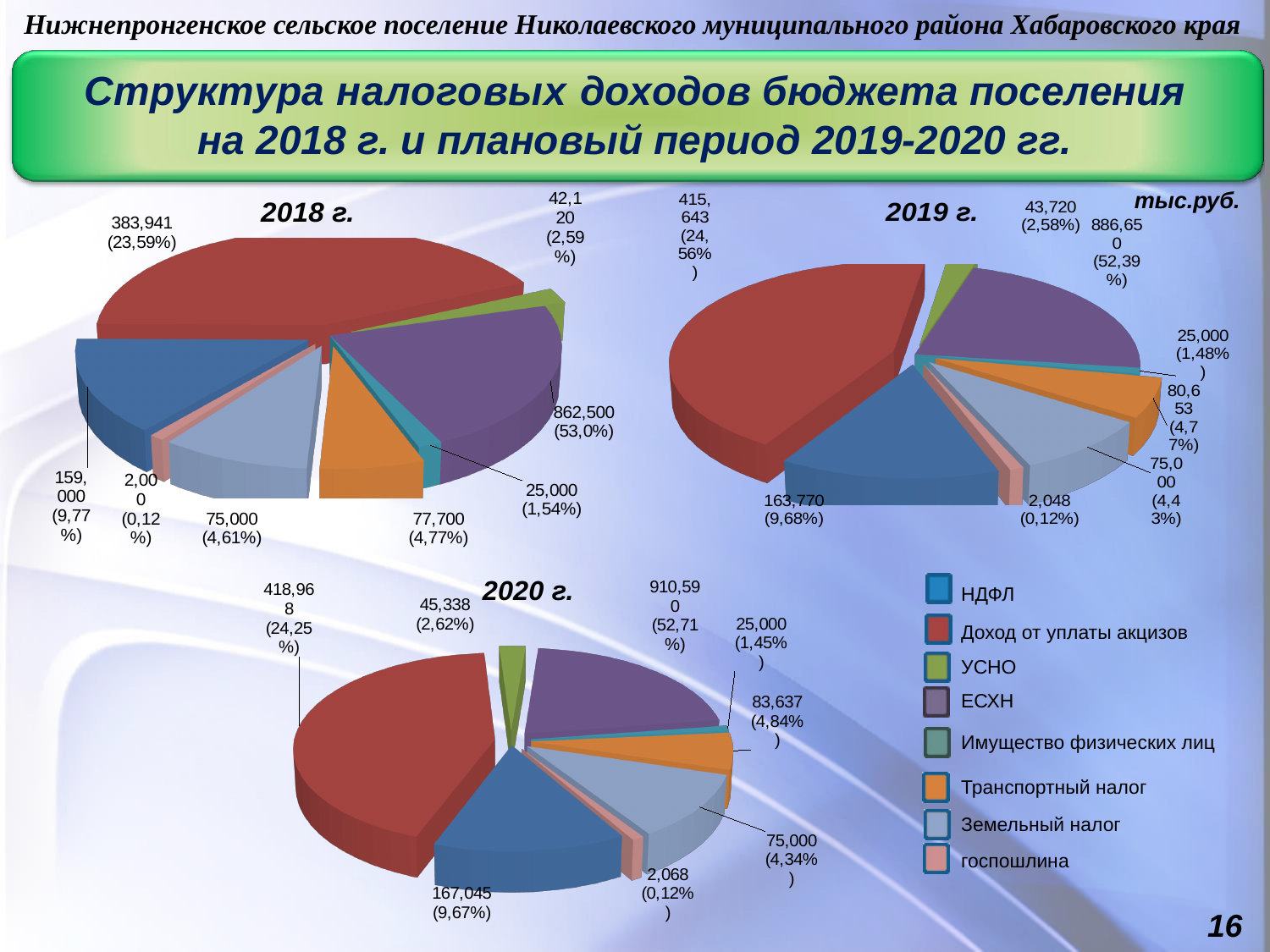
In the 2020 г. chart, which is larger: Земельный налог or Транспортный налог? Транспортный налог In the 2018 г. chart, which category has the largest share? ЕСХН In the 2020 г. chart, what share does Транспортный налог have? 4,84% In the 2018 г. chart, which category has the smallest share? госпошлина How many entries does the legend list? 8 What unit is stated for the values on the slide? тыс.руб. What is the difference between the НДФЛ value in the 2020 г. chart and the НДФЛ value in the 2018 г. chart? 8,045 In the 2019 г. chart, what is the value for НДФЛ? 163,770 (9,68%) In the 2019 г. chart, what share does Доход от уплаты акцизов have? 24,56% What kind of charts are shown on the slide? Pie charts In the 2018 г. chart, what is the value for ЕСХН? 862,500 (53,0%) In the 2020 г. chart, what is the value for ЕСХН? 910,590 (52,71%)